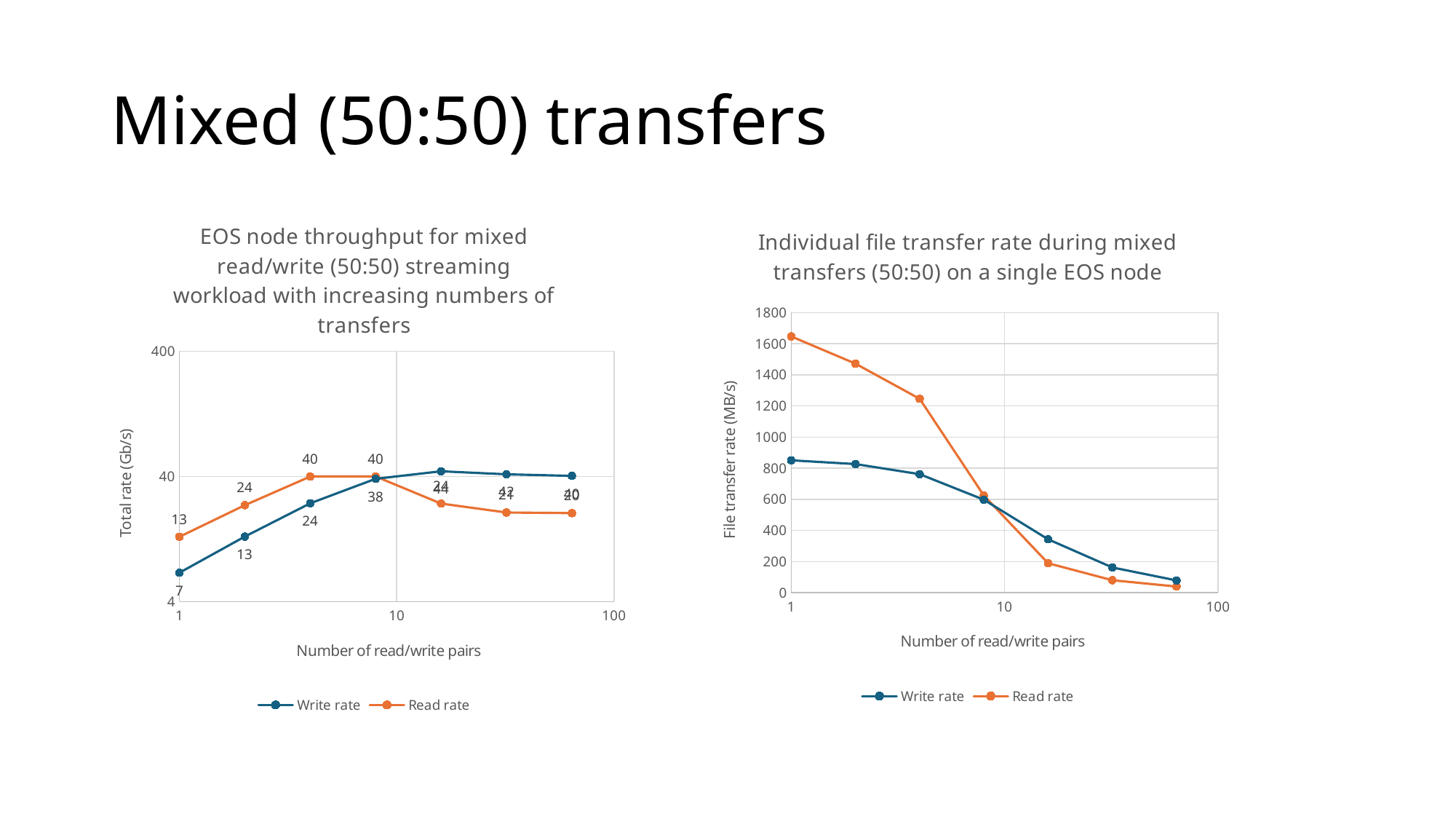
In the left chart (EOS node throughput), what is the Write rate at 8 read/write pairs? 38 In the right chart (Individual file transfer rate), is the Read rate at 1 read/write pair greater or less than 1400? greater In the left chart (EOS node throughput), what is the Write rate at 1 read/write pair? 7 What is the y-axis label of the right chart (Individual file transfer rate)? File transfer rate (MB/s) In the left chart (EOS node throughput), which series has the higher value at 2 read/write pairs, Write rate or Read rate? Read rate In the right chart (Individual file transfer rate), does the Read rate rise or fall as the number of read/write pairs increases? Falls What kind of chart is the left chart, 'EOS node throughput for mixed read/write (50:50) streaming workload with increasing numbers of transfers'? Line chart In the left chart (EOS node throughput), how many series does the legend list? 2 In the left chart (EOS node throughput), what is the Read rate at 4 read/write pairs? 40 In the right chart (Individual file transfer rate), is the Write rate at 1 read/write pair greater or less than 1000? less In the left chart (EOS node throughput), what is the difference between the Read rate and the Write rate at 1 read/write pair? 6 In the left chart (EOS node throughput), how many data points does the Write rate series have? 7